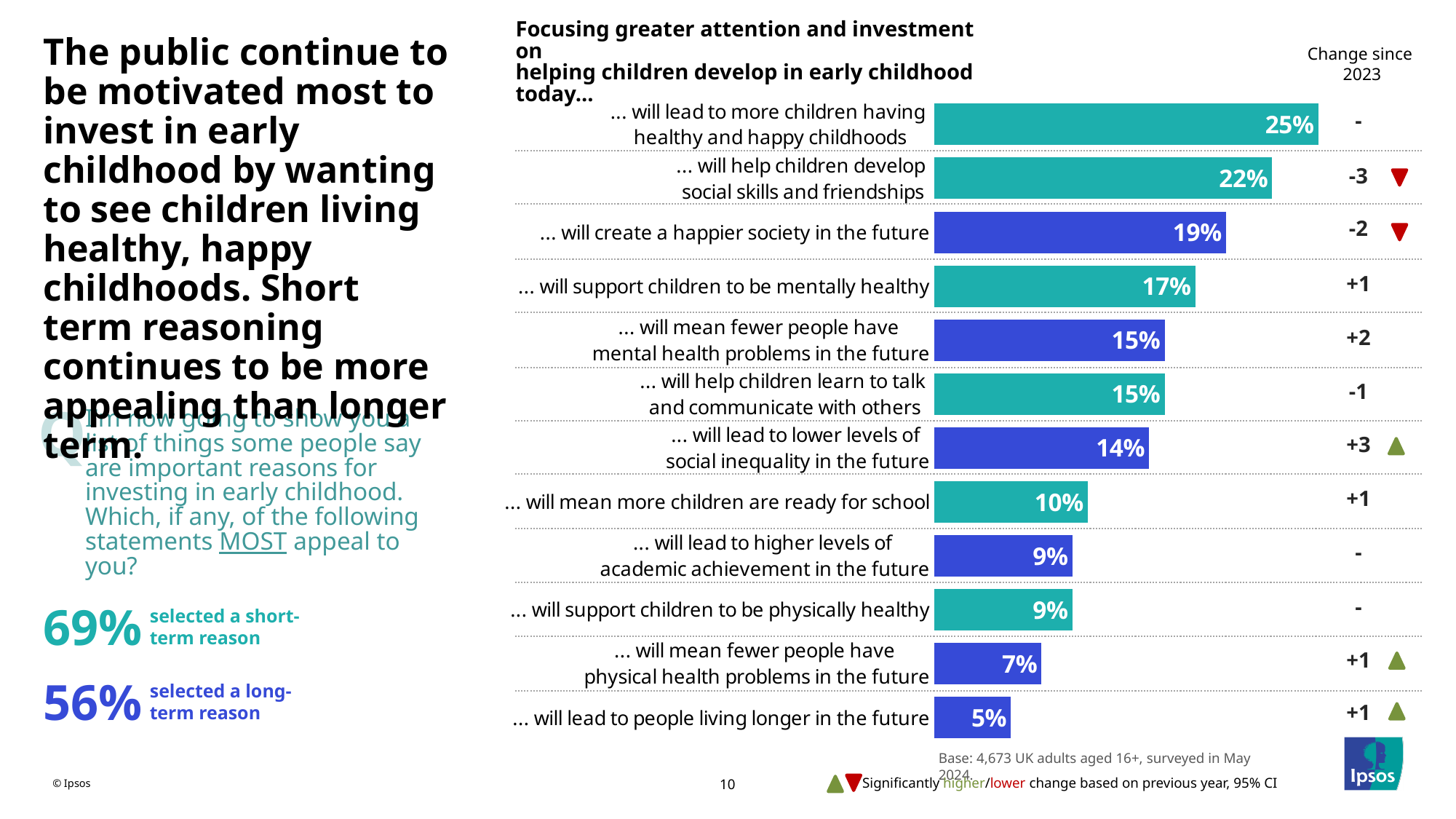
What is the "Change since 2023" shown for "will help children develop social skills and friendships"? -3 Do the bar values rise or fall going from the top of the chart to the bottom? Fall What kind of chart is shown on the slide? Bar chart Which statement has the lowest percentage in the chart? ... will lead to people living longer in the future Which is larger: the value for "will support children to be physically healthy" or the value for "will mean fewer people have physical health problems in the future"? ... will support children to be physically healthy What is the difference in percentage points between "will help children develop social skills and friendships" and "will lead to lower levels of social inequality in the future"? 8 What percentage selected "will create a happier society in the future"? 19% Which statement has the highest percentage in the chart? ... will lead to more children having healthy and happy childhoods What percentage selected "will support children to be mentally healthy"? 17% How many statements (bars) are shown in the chart? 12 What is the "Change since 2023" shown for "will lead to lower levels of social inequality in the future"? +3 What percentage selected "will mean more children are ready for school"? 10%